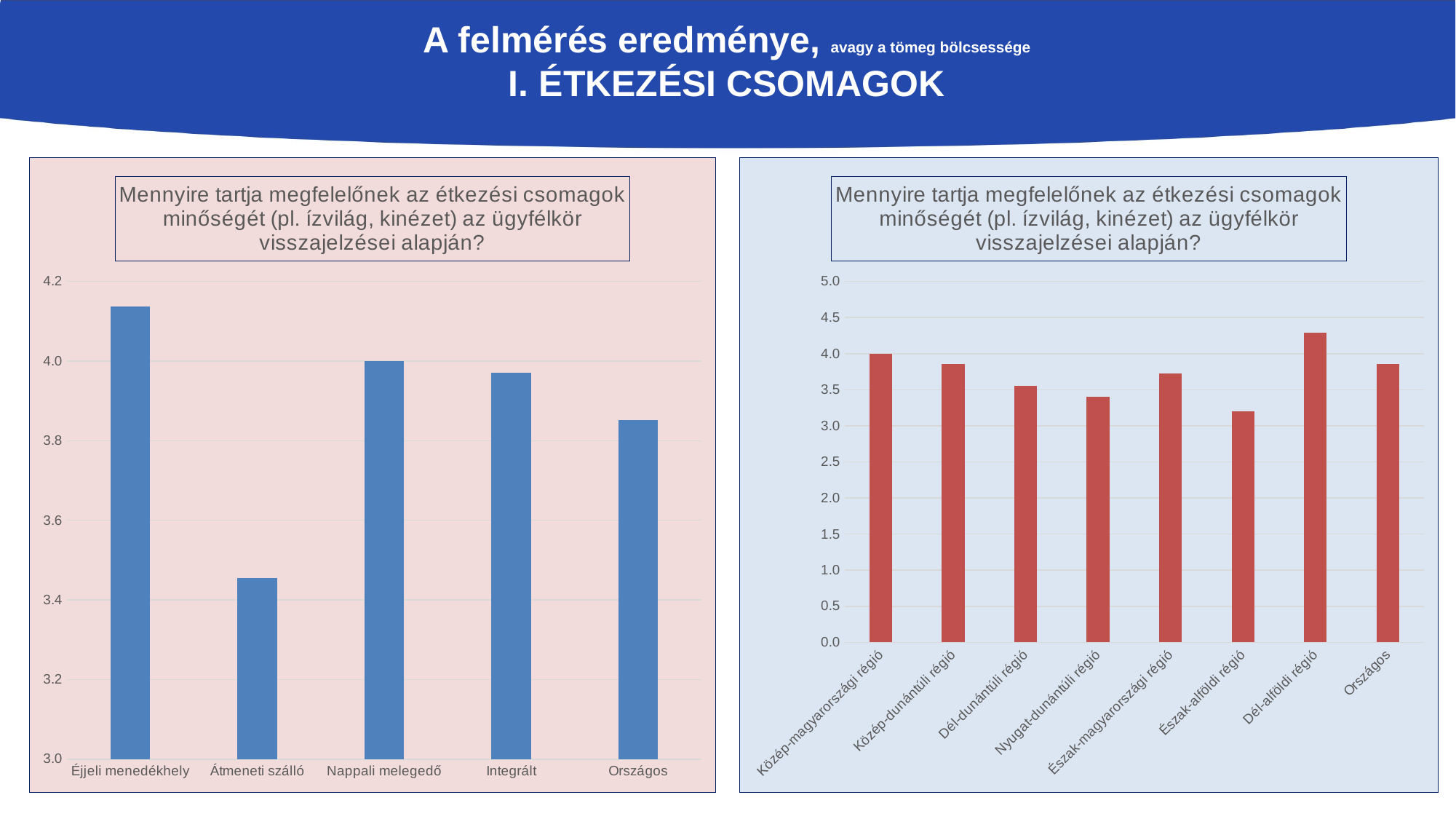
In the right chart (blue background), which is larger: the value for Dél-alföldi régió or the value for Nyugat-dunántúli régió? Dél-alföldi régió In the right chart (blue background), which region has the lowest value? Észak-alföldi régió In the left chart (pink background), is the value for Éjjeli menedékhely greater or less than 4.0? greater In the right chart (blue background), which region has the highest value? Dél-alföldi régió How many categories are shown on the x axis of the right chart (blue background)? 8 How many categories are shown on the x axis of the left chart (pink background)? 5 What kind of chart is the left chart (pink background)? bar chart In the left chart (pink background), which category has the lowest value? Átmeneti szálló In the right chart (blue background), is the value for Észak-alföldi régió greater or less than 3.5? less In the left chart (pink background), which is larger: the value for Éjjeli menedékhely or the value for Országos? Éjjeli menedékhely In the left chart (pink background), is the value for Átmeneti szálló greater or less than 3.6? less In the left chart (pink background), which category has the highest value? Éjjeli menedékhely